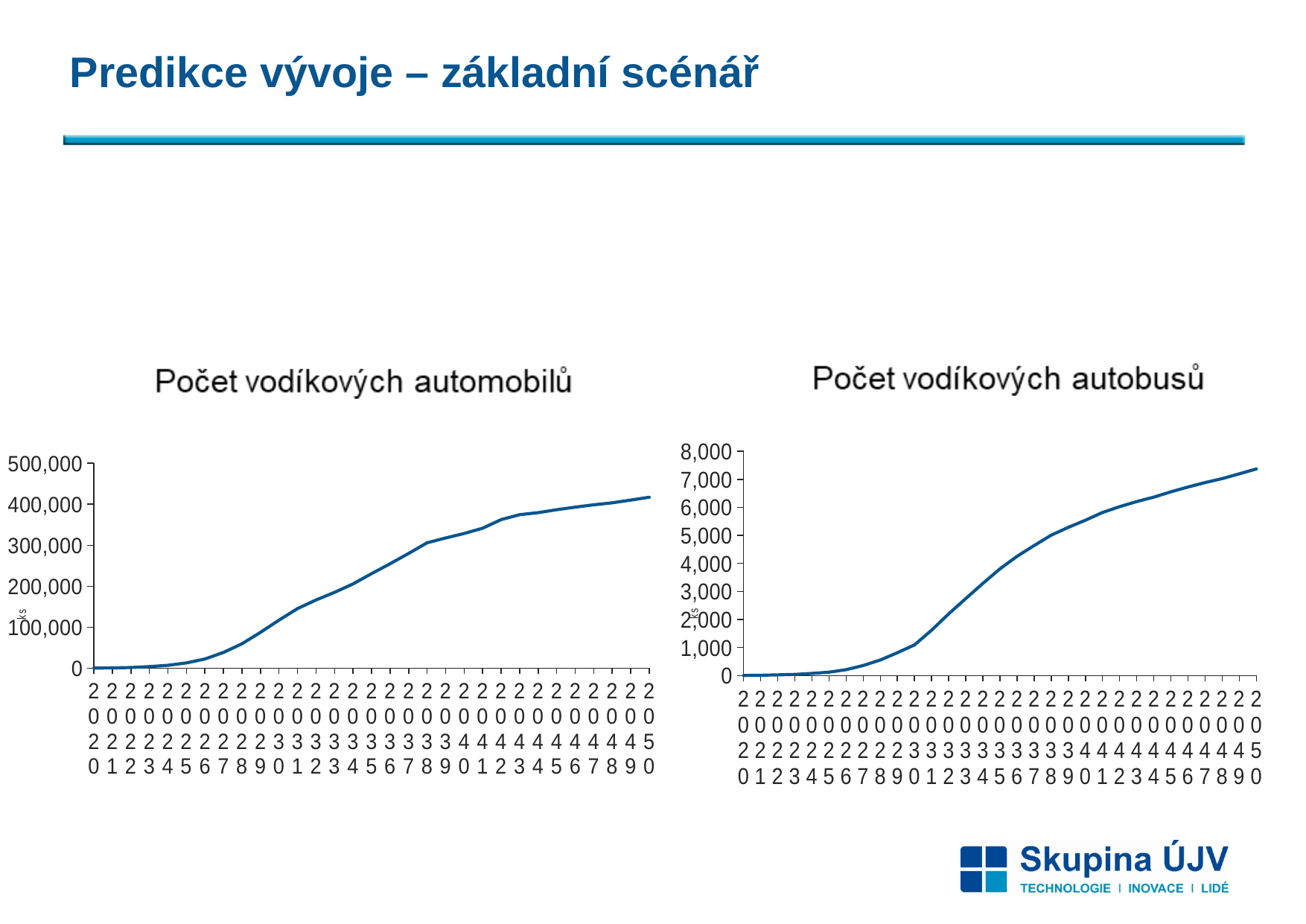
In the 'Počet vodíkových automobilů' chart, is the value for 2025 greater or less than 100,000? less In the 'Počet vodíkových autobusů' chart, is the value for 2025 greater or less than 1,000? less In the 'Počet vodíkových autobusů' chart, do the values rise or fall along the x axis? rise How many years are plotted on the x axis of the 'Počet vodíkových autobusů' chart? 31 In the 'Počet vodíkových automobilů' chart, is the value for 2050 greater or less than 400,000? greater In the 'Počet vodíkových autobusů' chart, which year has the lowest value? 2020 In the 'Počet vodíkových automobilů' chart, which year has the highest value? 2050 What kind of chart is the 'Počet vodíkových autobusů' chart on the right? line chart In the 'Počet vodíkových automobilů' chart, do the values rise or fall from 2020 to 2050? rise What kind of chart is the 'Počet vodíkových automobilů' chart on the left? line chart What is the title of the chart on the left of the slide? Počet vodíkových automobilů